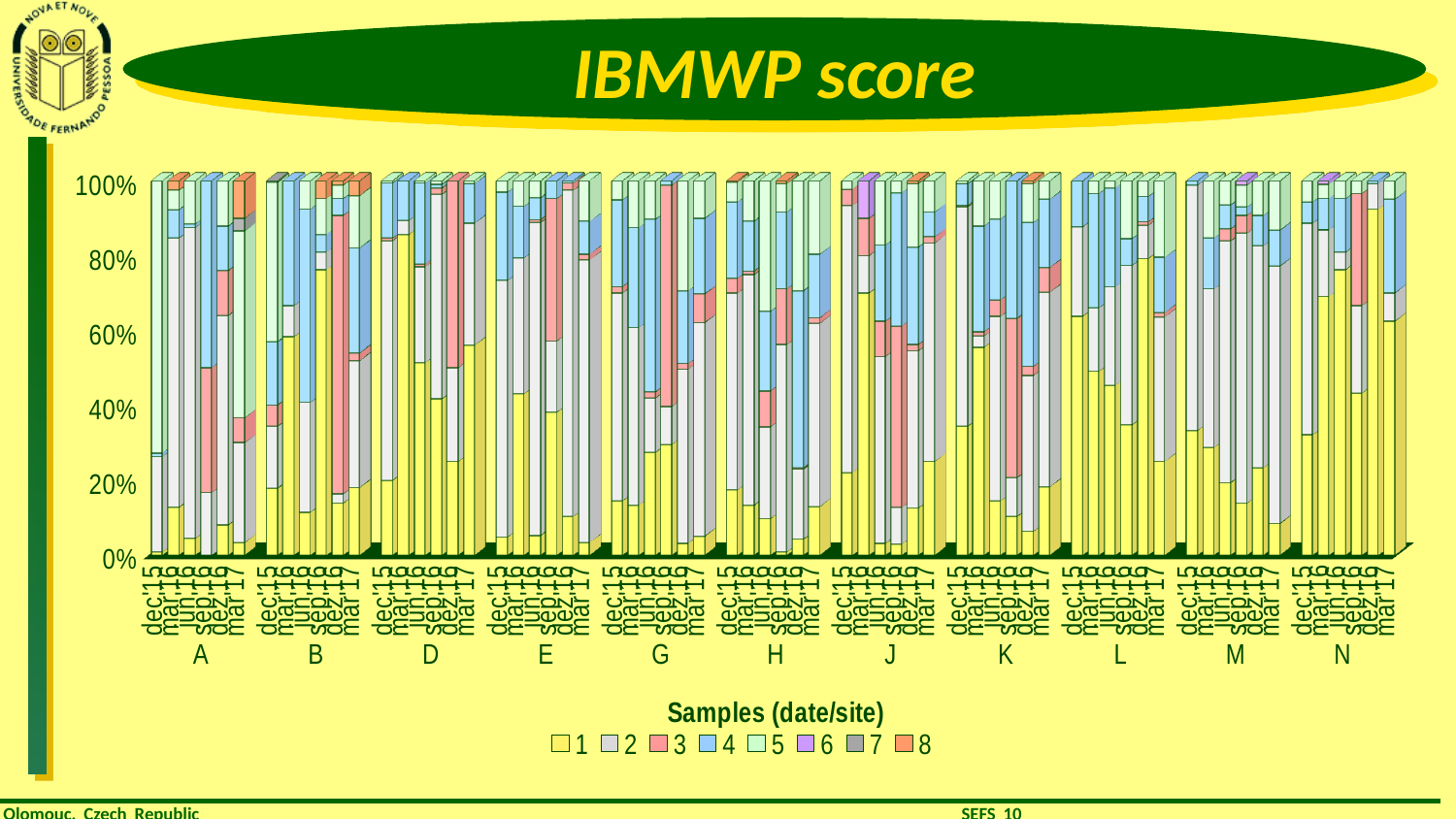
How many sites are shown along the x axis of the chart? 11 What is the highest value shown on the y axis? 100% What kind of chart is shown on the slide? Stacked bar chart What is the title of the chart? IBMWP score Which site label comes first on the x axis? A How many sampling dates are shown for each site? 6 Is the share of series 1 in the dec.15 bar for site D greater or less than 60%? less What does each full stacked bar add up to? 100% Which site label comes last on the x axis? N What is the label of the x axis? Samples (date/site) Is the share of series 1 in the dec.15 bar for site N greater or less than 40%? less How many series does the legend list? 8